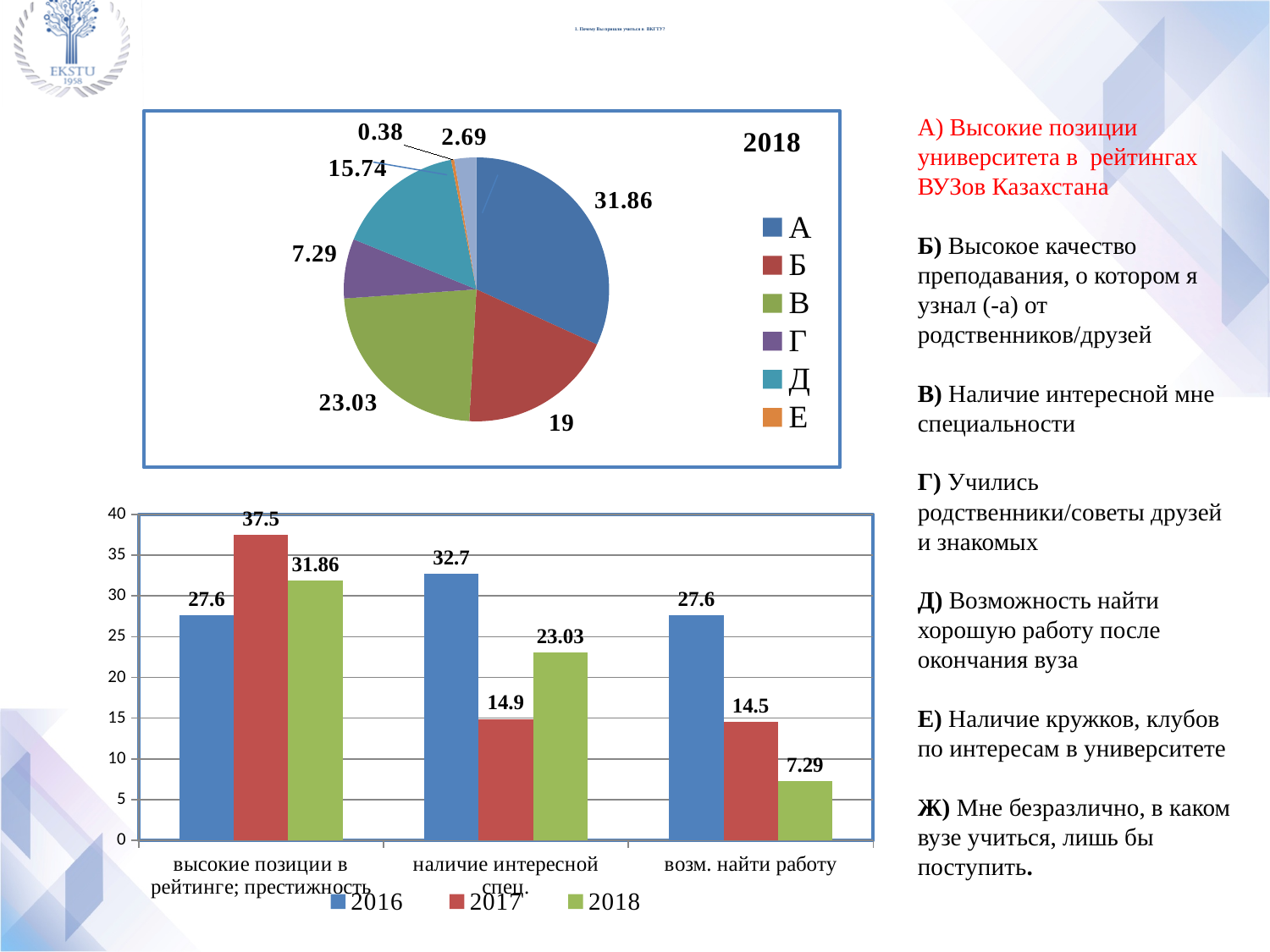
In the bottom bar chart, which year has the highest value for 'наличие интересной спец.'? 2016 In the pie chart titled 2018, what is the value for slice А? 31.86 In the bottom bar chart, what is the 2017 value for 'высокие позиции в рейтинге; престижность'? 37.5 In the pie chart titled 2018, which legend category has the smallest slice? Е In the pie chart titled 2018, how many entries does the legend list? 6 In the pie chart titled 2018, what is the difference between the values for В and Б? 4.03 In the bottom bar chart, is the 2016 value for 'наличие интересной спец.' larger or smaller than the 2017 value? larger In the pie chart titled 2018, what is the value for slice Д? 15.74 What kind of chart is the bottom chart on the slide? bar chart In the bottom bar chart, how many series does the legend list? 3 In the pie chart titled 2018, which legend category has the largest slice? А In the bottom bar chart, what is the 2018 value for 'возм. найти работу'? 7.29